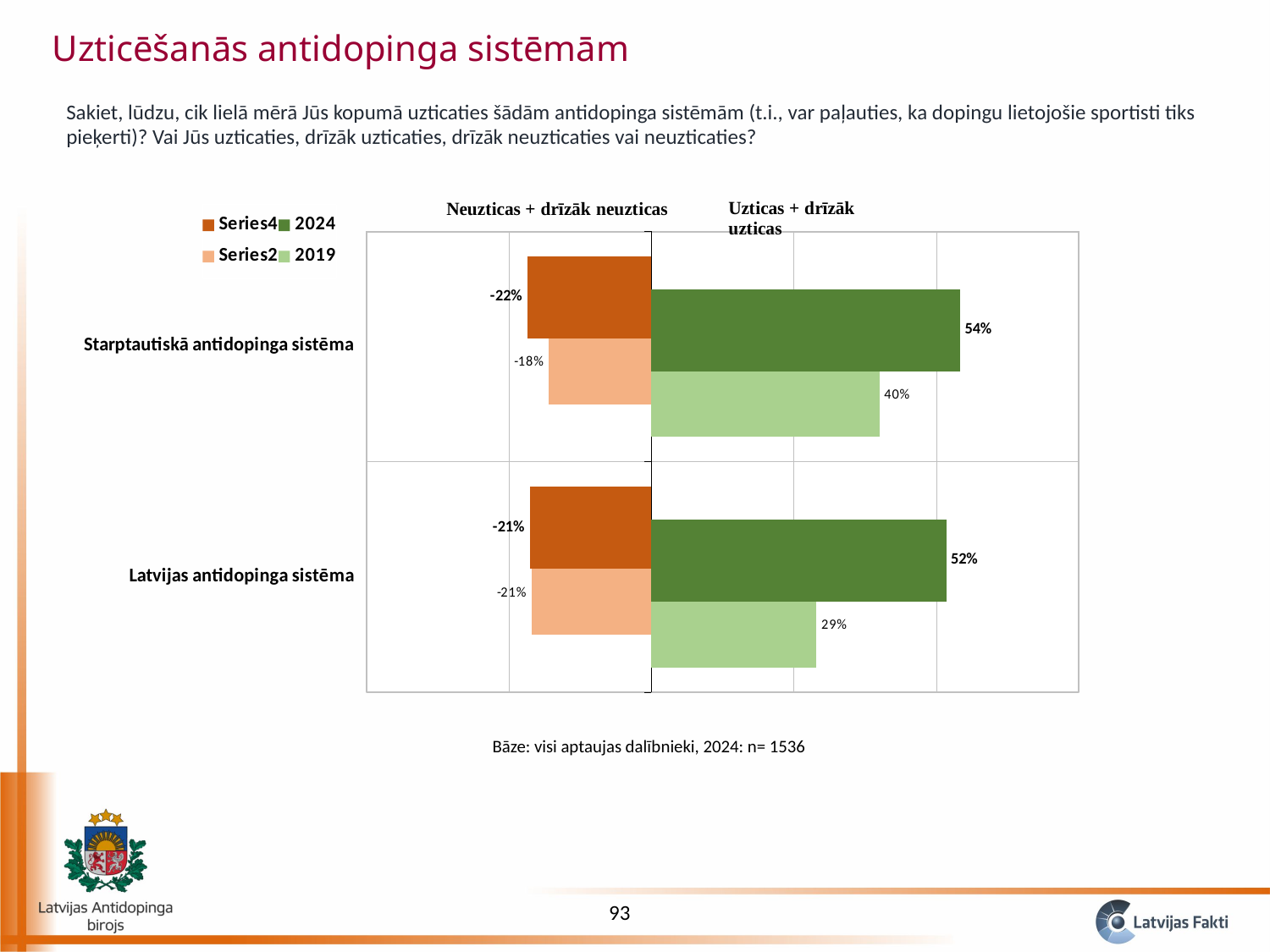
How many entries does the chart legend list? 4 What is the difference between the 2024 and 2019 'Uzticas + drīzāk uzticas' values for Starptautiskā antidopinga sistēma? 14 percentage points What is the 2019 'Neuzticas + drīzāk neuzticas' value for Starptautiskā antidopinga sistēma? -18% How many categories are shown on the chart? 2 Which category has the higher 2024 'Uzticas + drīzāk uzticas' value? Starptautiskā antidopinga sistēma By how many percentage points did the 'Uzticas + drīzāk uzticas' value for Latvijas antidopinga sistēma change from 2019 to 2024? 23 percentage points What is the 2019 'Uzticas + drīzāk uzticas' value for Latvijas antidopinga sistēma? 29% What is the 2024 'Uzticas + drīzāk uzticas' value for Latvijas antidopinga sistēma? 52% What is the 2024 'Neuzticas + drīzāk neuzticas' value for Latvijas antidopinga sistēma? -21% Which category has the lower 2019 'Uzticas + drīzāk uzticas' value? Latvijas antidopinga sistēma Is the 2019 'Uzticas + drīzāk uzticas' value for Starptautiskā antidopinga sistēma larger or smaller than the 2019 value for Latvijas antidopinga sistēma? larger What is the 2024 'Uzticas + drīzāk uzticas' value for Starptautiskā antidopinga sistēma? 54%